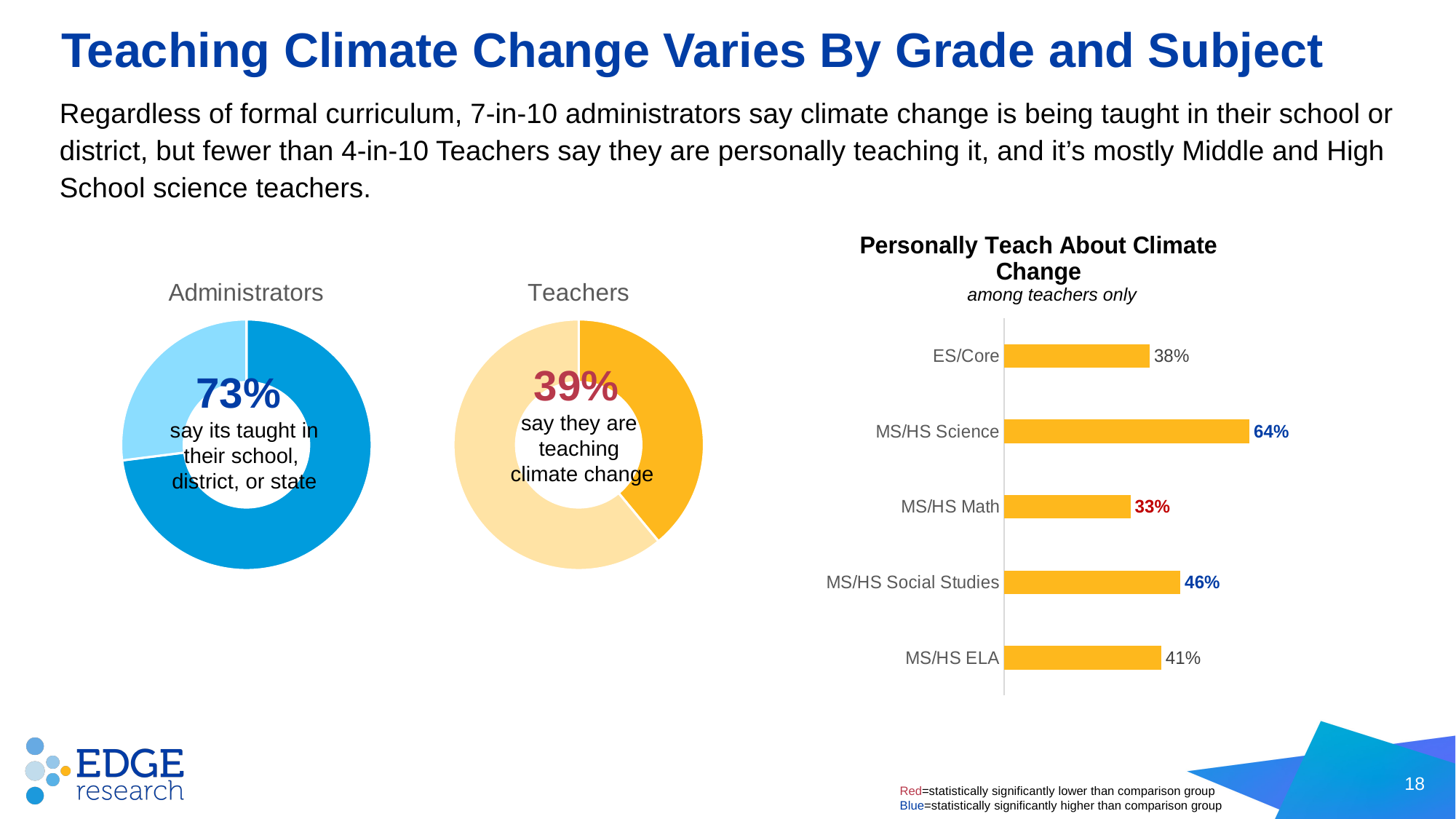
What is the difference between the Administrators donut value and the Teachers donut value? 34% In the Administrators donut chart, what percentage say climate change is taught in their school, district, or state? 73% In the 'Personally Teach About Climate Change' bar chart, which is larger: MS/HS Social Studies or MS/HS ELA? MS/HS Social Studies In the 'Personally Teach About Climate Change' bar chart, what is the difference between MS/HS Science and MS/HS Math? 31% In the 'Personally Teach About Climate Change' bar chart, what is the value for MS/HS ELA? 41% In the 'Personally Teach About Climate Change' bar chart, what is the value for ES/Core? 38% In the 'Personally Teach About Climate Change' bar chart, what is the value for MS/HS Science? 64% What kind of chart is the 'Personally Teach About Climate Change' chart? Bar chart In the Teachers donut chart, what percentage say they are teaching climate change? 39% In the 'Personally Teach About Climate Change' bar chart, which category has the lowest value? MS/HS Math How many categories are shown in the 'Personally Teach About Climate Change' bar chart? 5 In the 'Personally Teach About Climate Change' bar chart, which category has the highest value? MS/HS Science